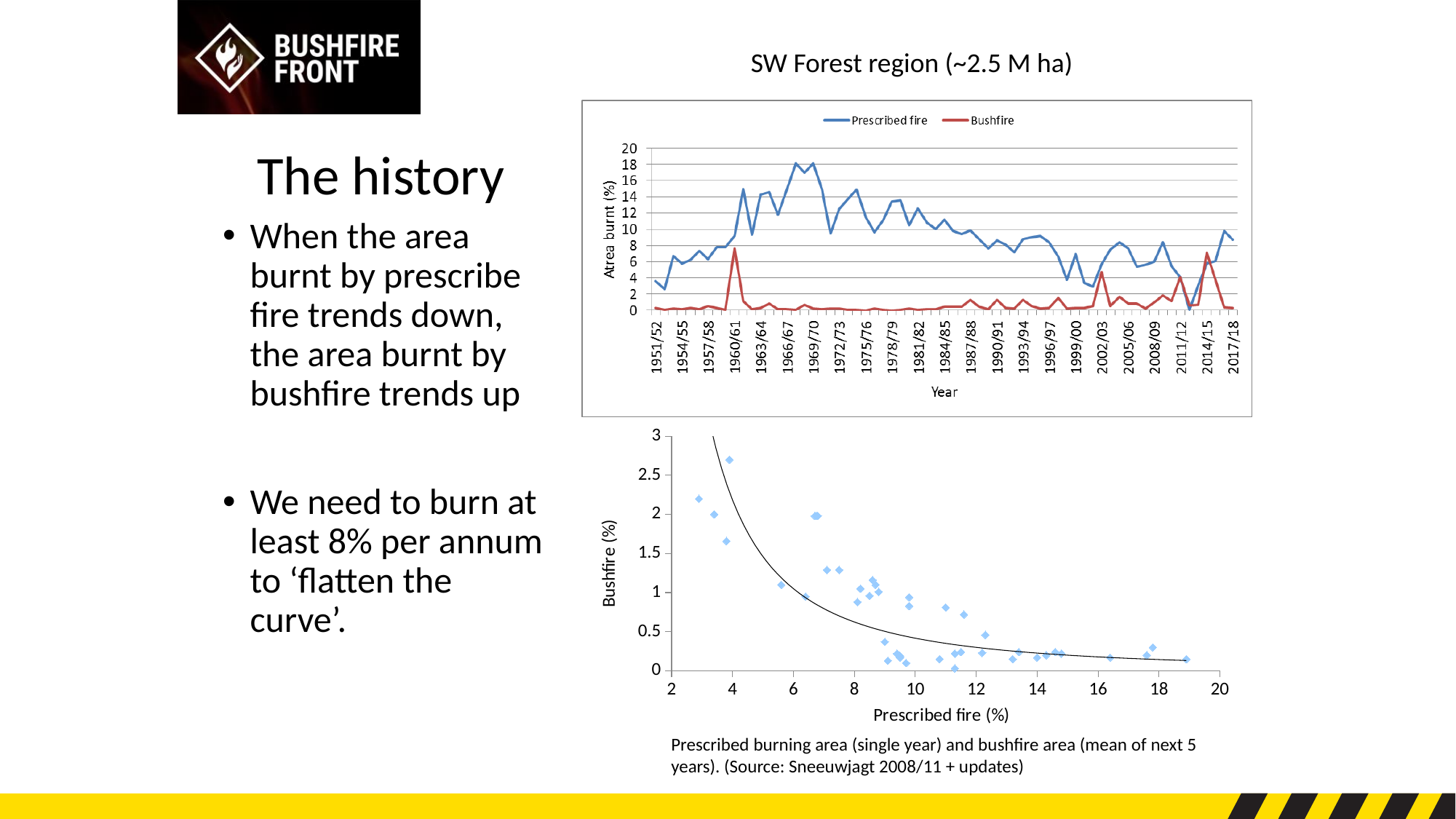
In the bottom scatter chart, is the highest Bushfire (%) point greater or less than 2.5? greater In the top chart 'SW Forest region (~2.5 M ha)', what is the y-axis title? Atrea burnt (%) In the top chart 'SW Forest region (~2.5 M ha)', is the Bushfire value for 1960/61 greater or less than 6? greater In the top chart 'SW Forest region (~2.5 M ha)', which series has the larger value in 1969/70, Prescribed fire or Bushfire? Prescribed fire In the top chart 'SW Forest region (~2.5 M ha)', is the Prescribed fire value for 1969/70 greater or less than 16? greater What kind of chart is the bottom chart with 'Prescribed fire (%)' on the x axis? scatter chart What kind of chart is the top chart titled 'SW Forest region (~2.5 M ha)'? line chart In the top chart 'SW Forest region (~2.5 M ha)', which series is drawn in red? Bushfire In the top chart 'SW Forest region (~2.5 M ha)', how many series does the legend list? 2 In the top chart 'SW Forest region (~2.5 M ha)', does the Prescribed fire series generally rise or fall from 1969/70 to 2011/12? fall In the bottom scatter chart, does Bushfire (%) generally rise or fall as Prescribed fire (%) increases? fall